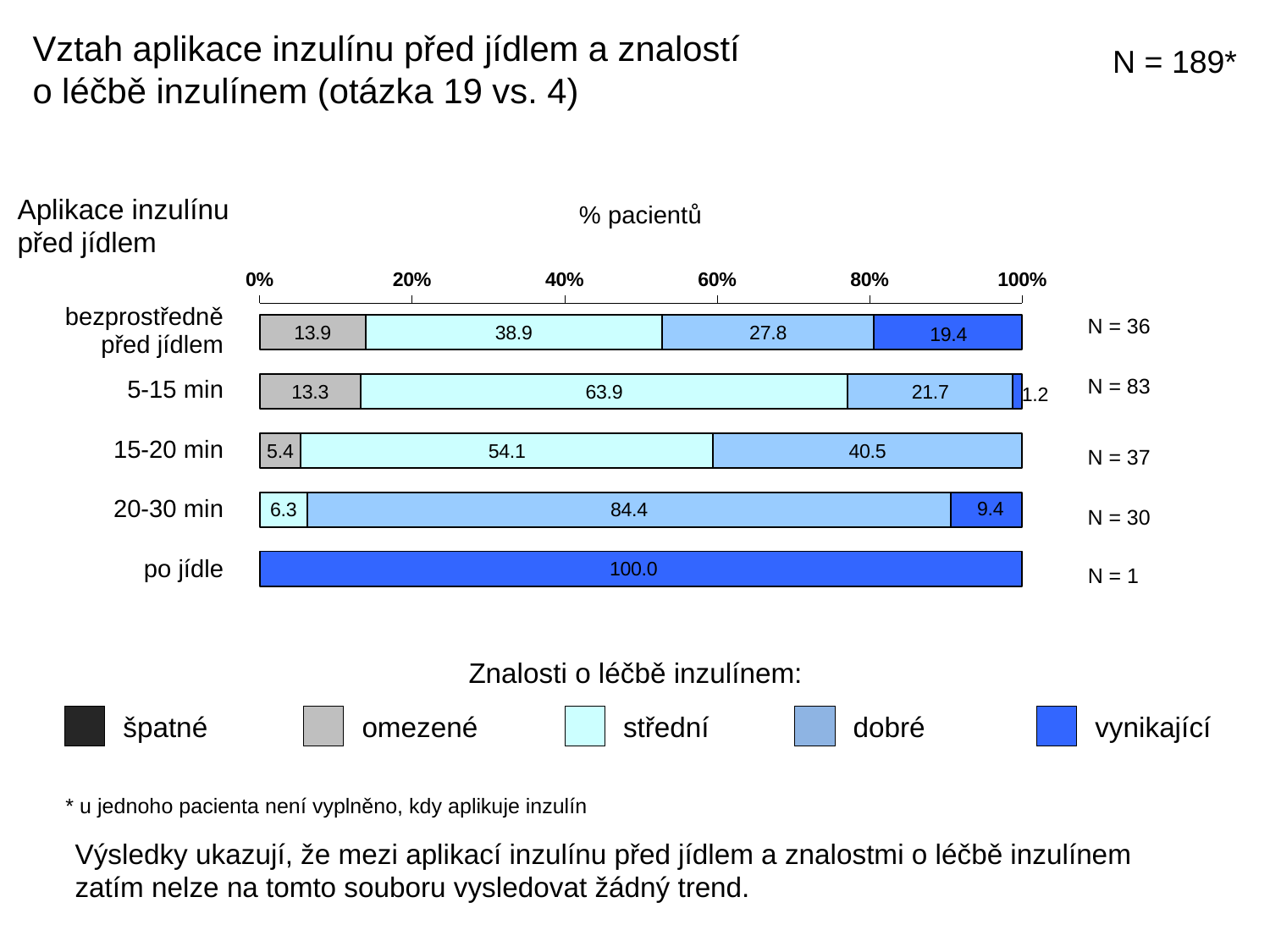
What is the value for 'vynikající' in the '20-30 min' bar? 9.4 Which category has the lowest value for 'omezené' among those where it is shown? 15-20 min What kind of chart is shown on the slide? stacked bar chart Which category has the highest value for 'dobré'? 20-30 min What is the N value shown next to the '5-15 min' bar? N = 83 What is the value for 'dobré' in the '5-15 min' bar? 21.7 Which is larger: the 'vynikající' value for 'bezprostředně před jídlem' or for '20-30 min'? bezprostředně před jídlem How many categories of insulin application timing are shown on the chart? 5 What is the value for 'střední' in the 'bezprostředně před jídlem' bar? 38.9 What is the value for 'omezené' in the '15-20 min' bar? 5.4 How many series does the legend list? 5 What is the difference between the 'střední' values for '5-15 min' and 'bezprostředně před jídlem'? 25.0